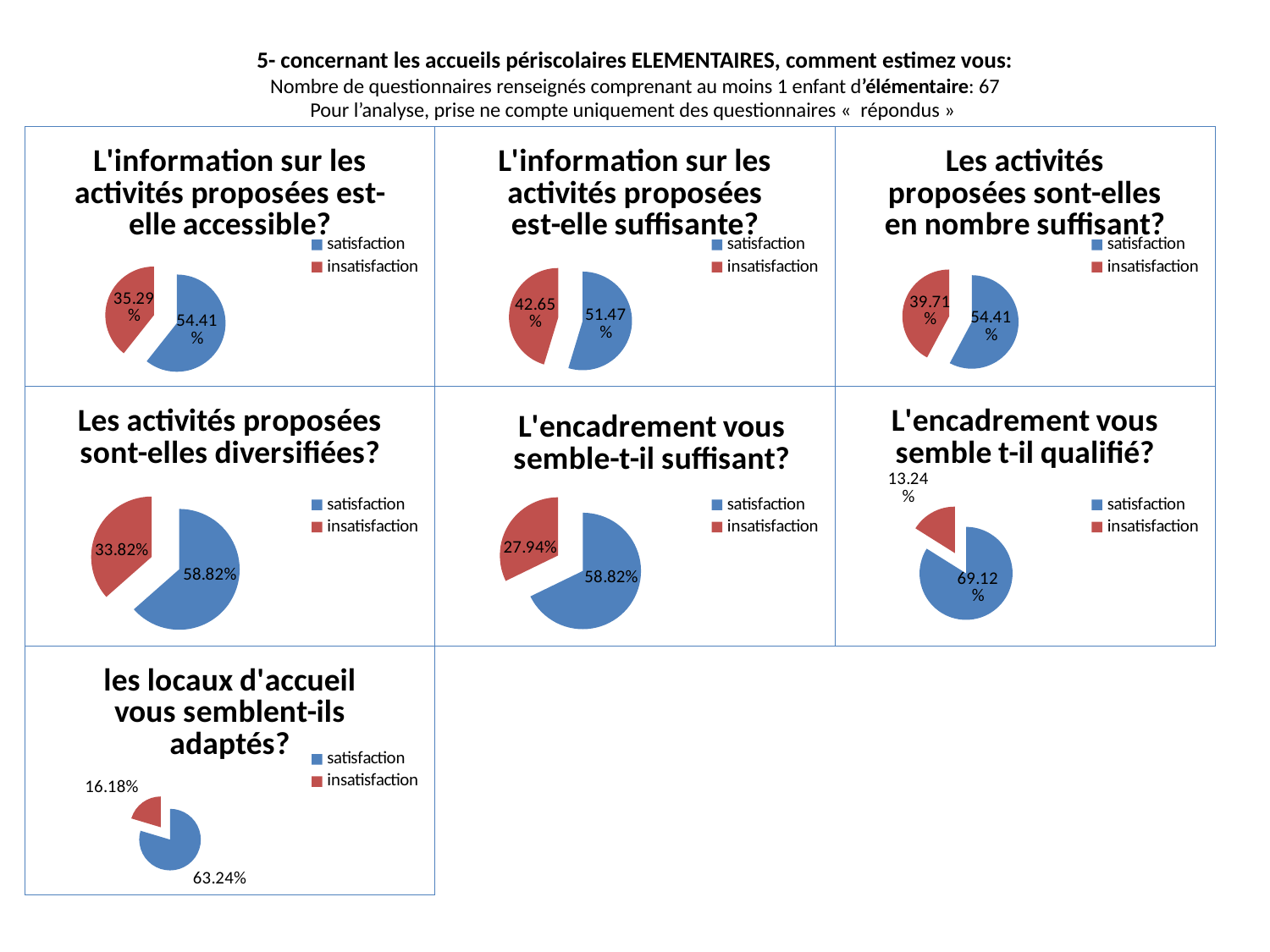
In the chart titled "L'information sur les activités proposées est-elle suffisante?", what is the value for insatisfaction? 42.65% In the chart titled "L'encadrement vous semble t-il qualifié?", what is the value for satisfaction? 69.12% What kind of chart is used for "L'encadrement vous semble t-il qualifié?"? pie chart In the chart titled "L'information sur les activités proposées est-elle suffisante?", what colour is the satisfaction slice? blue In the chart titled "L'information sur les activités proposées est-elle accessible?", what is the difference between the satisfaction and insatisfaction values? 19.12 percentage points How many series does the legend list in the chart titled "Les activités proposées sont-elles diversifiées?"? 2 In the chart titled "Les activités proposées sont-elles diversifiées?", which slice is larger, satisfaction or insatisfaction? satisfaction In the chart titled "Les activités proposées sont-elles en nombre suffisant?", what is the value for insatisfaction? 39.71% In the chart titled "L'information sur les activités proposées est-elle accessible?", what is the value for satisfaction? 54.41% In the chart titled "les locaux d'accueil vous semblent-ils adaptés?", what is the value for insatisfaction? 16.18% In the chart titled "L'encadrement vous semble-t-il suffisant?", what is the difference between the satisfaction and insatisfaction values? 30.88 percentage points How many pie charts are shown on the slide? 7